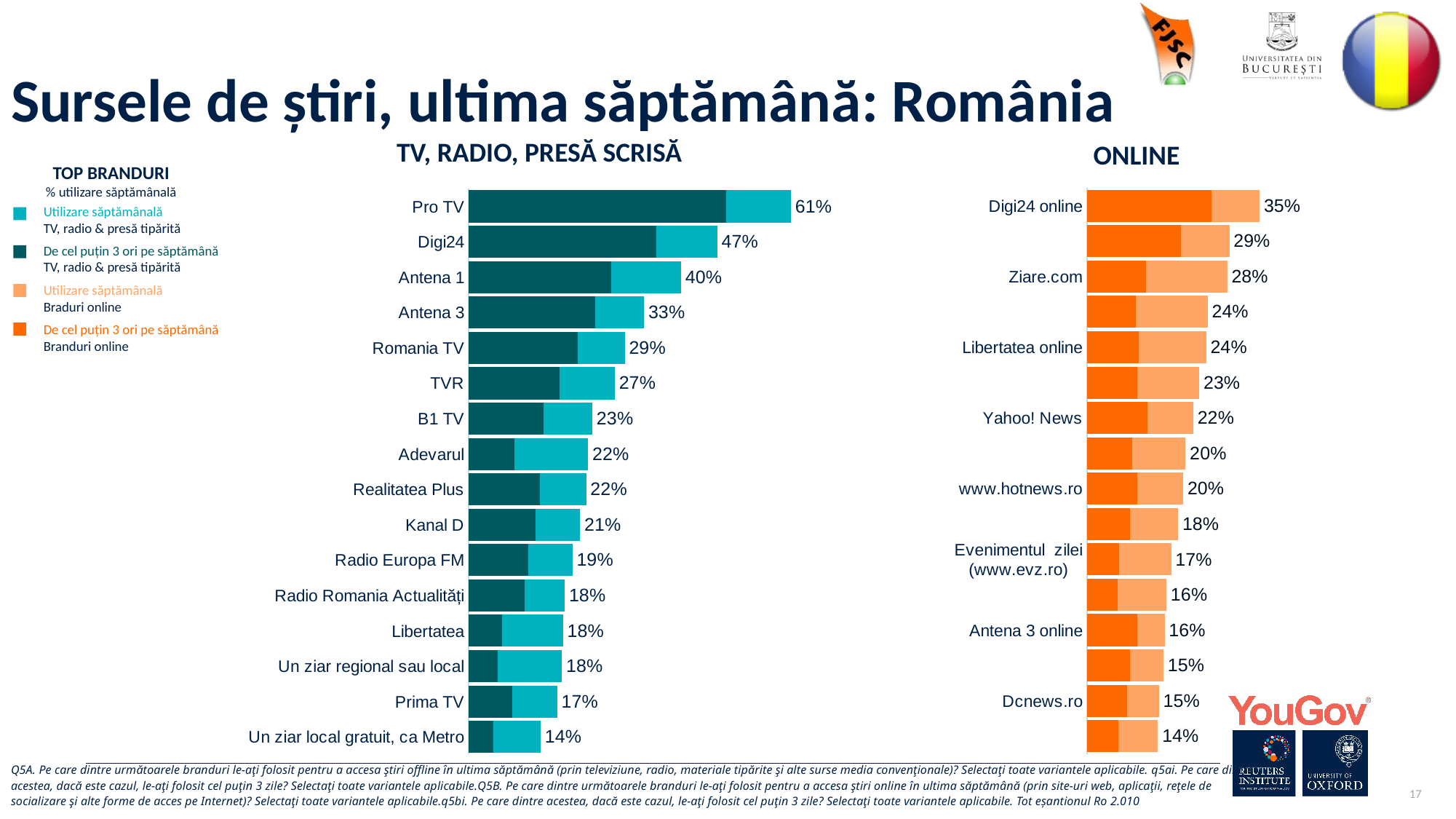
How many brands are listed in the TV, RADIO, PRESĂ SCRISĂ chart? 16 In the TV, RADIO, PRESĂ SCRISĂ chart, what is the value shown for Antena 3? 33% In the ONLINE chart, what is the value shown for Yahoo! News? 22% In the ONLINE chart, which brand has the highest weekly usage? Digi24 online In the TV, RADIO, PRESĂ SCRISĂ chart, which brand has the lowest weekly usage? Un ziar local gratuit, ca Metro In the TV, RADIO, PRESĂ SCRISĂ chart, what is the difference between the values for Pro TV and Digi24? 14% In the TV, RADIO, PRESĂ SCRISĂ chart, which has a higher value, TVR or Kanal D? TVR In the ONLINE chart, what is the difference between the values for Digi24 online and Dcnews.ro? 20% What type of chart is used for the TV, RADIO, PRESĂ SCRISĂ data? Bar chart How many legend entries are shown under TOP BRANDURI? 4 In the TV, RADIO, PRESĂ SCRISĂ chart, what is the weekly usage value for Pro TV? 61% In the ONLINE chart, what is the value shown for Ziare.com? 28%